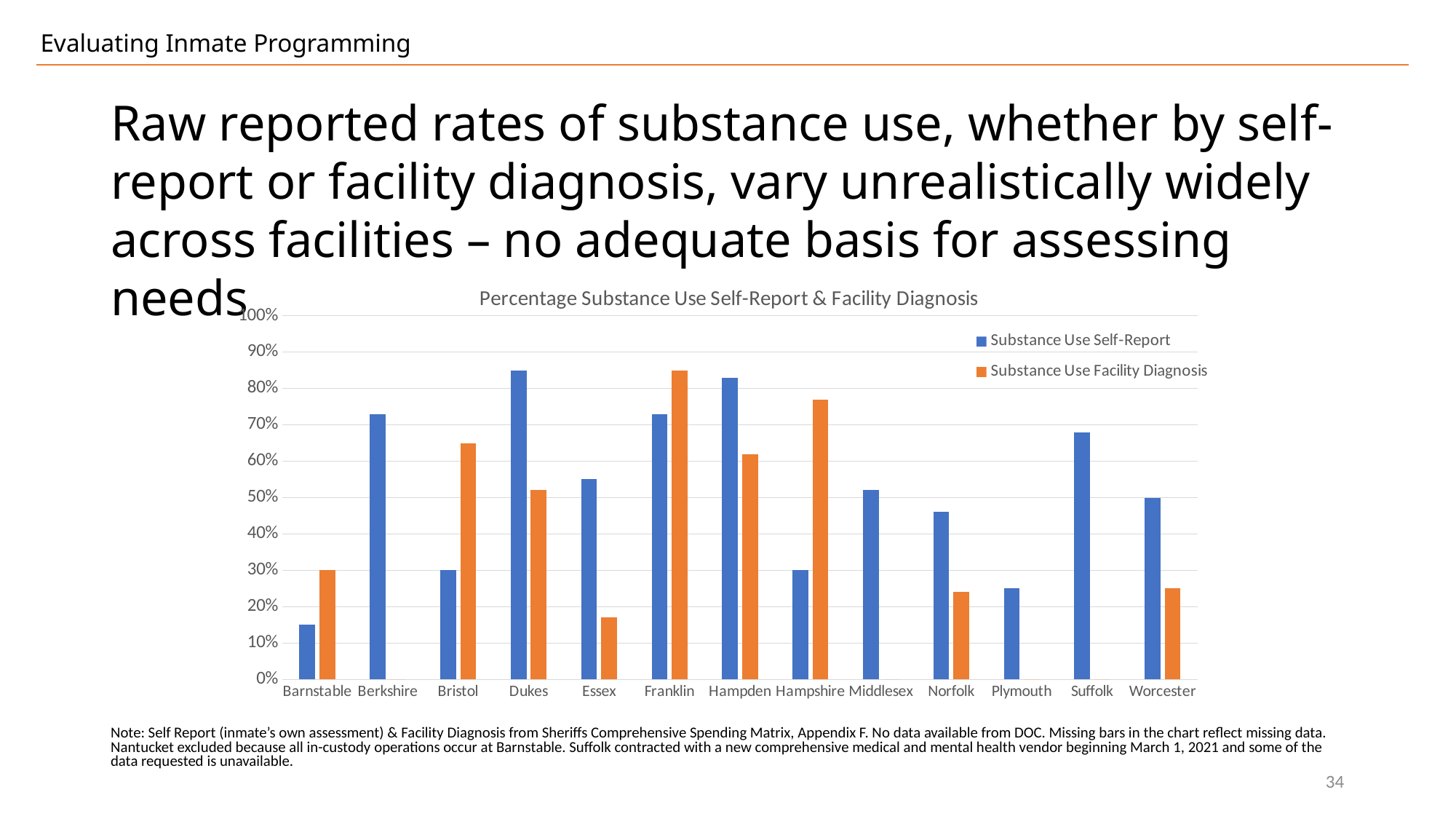
For Essex, which is larger: Substance Use Self-Report or Substance Use Facility Diagnosis? Substance Use Self-Report How many facilities are shown on the x axis of the chart? 13 Is the Substance Use Facility Diagnosis value for Hampshire greater or less than 70%? greater Is the Substance Use Self-Report value for Plymouth greater or less than 30%? less Which facility has the lowest Substance Use Facility Diagnosis value among those with a bar? Essex What is the title of the chart? Percentage Substance Use Self-Report & Facility Diagnosis Which facility has the highest Substance Use Facility Diagnosis value? Franklin How many series does the chart legend list? 2 Is the Substance Use Self-Report value for Berkshire greater or less than 60%? greater For Hampshire, which is larger: Substance Use Self-Report or Substance Use Facility Diagnosis? Substance Use Facility Diagnosis What type of chart is shown on the slide? Bar chart Which facility has the lowest Substance Use Self-Report value? Barnstable